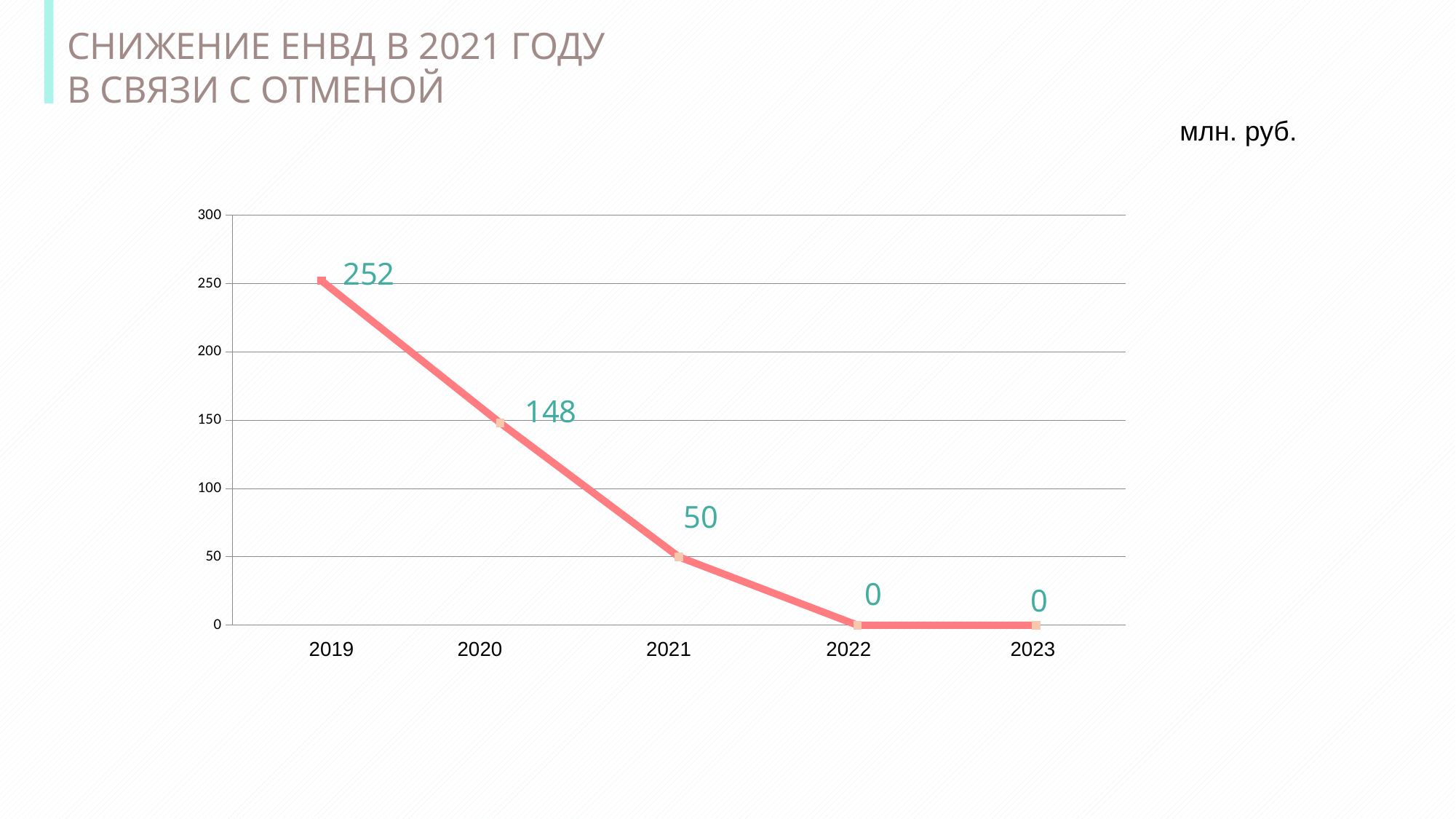
What kind of chart is shown on the slide? line chart Which year has the highest value? 2019 Which is larger, the value for 2020 or the value for 2021? 2020 Is the value for 2019 greater or less than 200? greater What is the difference between the values for 2020 and 2021? 98 How many years are plotted on the x axis? 5 What is the value for 2019? 252 What is the difference between the values for 2019 and 2020? 104 Do the values rise or fall from 2019 to 2022? fall What is the value for 2021? 50 What is the value for 2022? 0 What is the value for 2020? 148